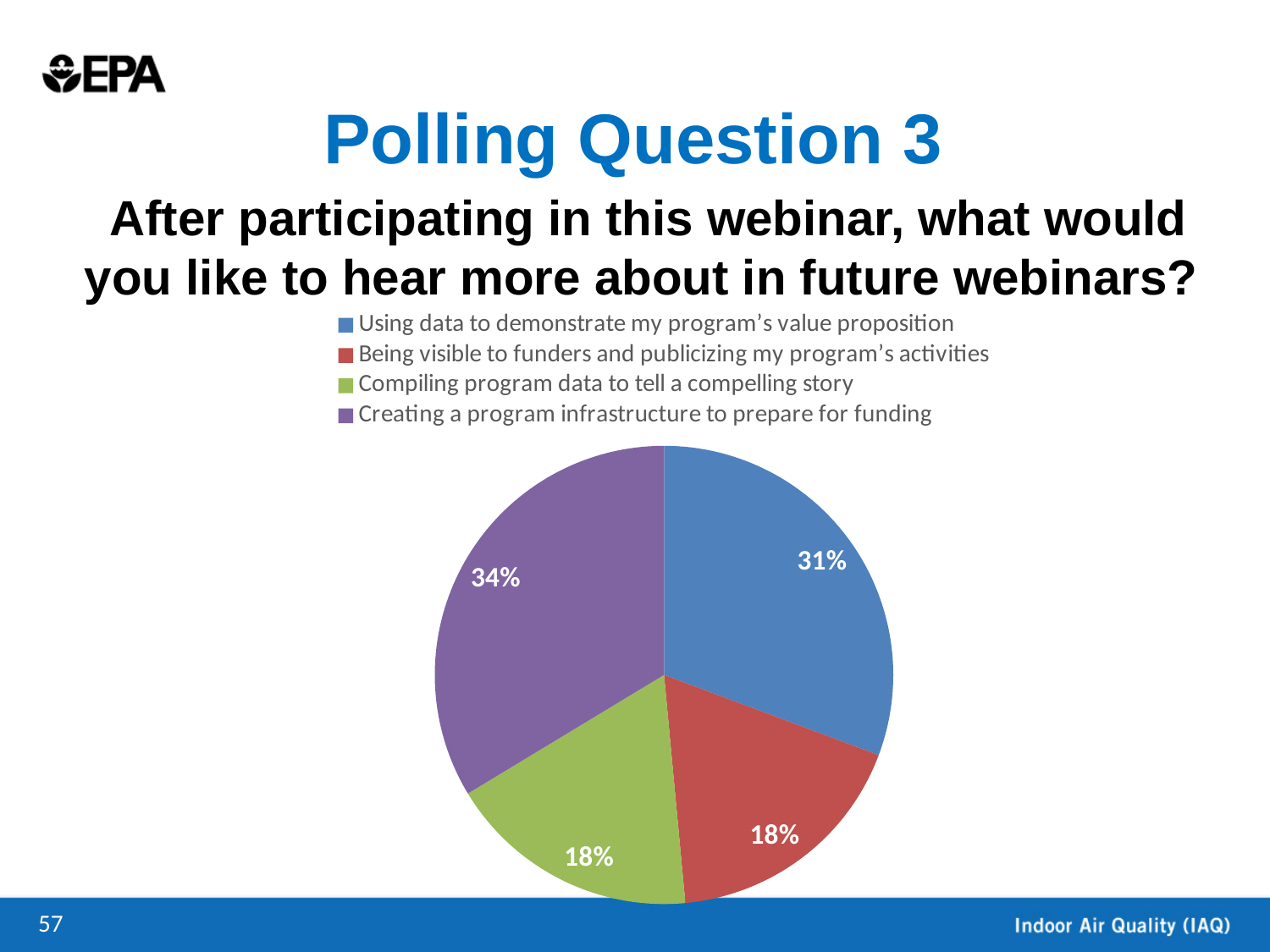
What share of the pie is 'Using data to demonstrate my program's value proposition'? 31% Which category has the largest slice of the pie? Creating a program infrastructure to prepare for funding What share of the pie is 'Compiling program data to tell a compelling story'? 18% What share of the pie is 'Being visible to funders and publicizing my program's activities'? 18% What kind of chart is shown on the slide? Pie chart What share of the pie is 'Creating a program infrastructure to prepare for funding'? 34% What is the combined share of the two 18% slices? 36% How many slices does the pie chart have? 4 What colour is the slice for 'Compiling program data to tell a compelling story'? Green What is the difference between the share for 'Creating a program infrastructure to prepare for funding' and the share for 'Using data to demonstrate my program's value proposition'? 3% How many entries does the legend list? 4 Which is larger: the share for 'Using data to demonstrate my program's value proposition' or the share for 'Compiling program data to tell a compelling story'? Using data to demonstrate my program's value proposition